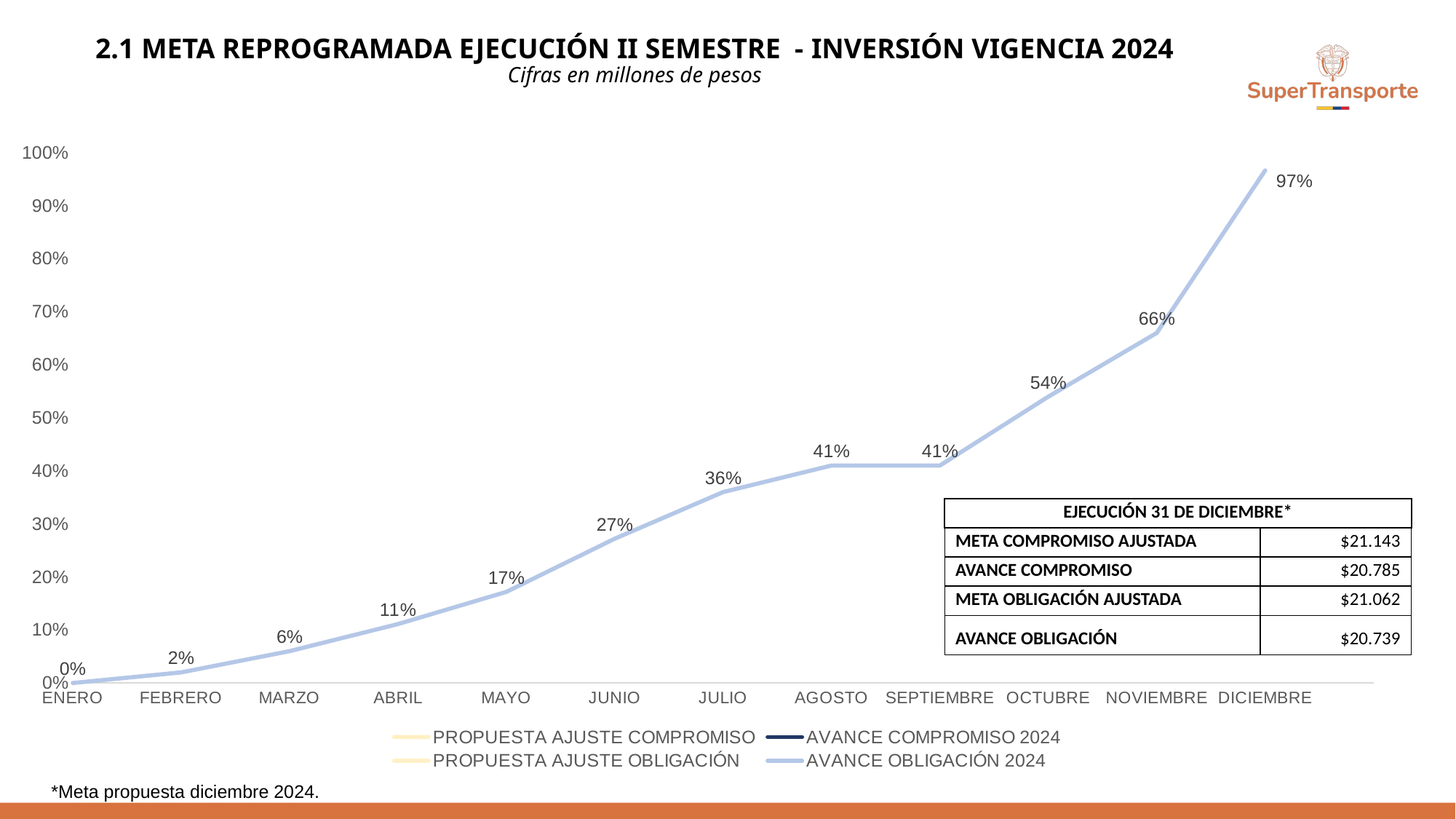
Which month has the highest value on the plotted line? DICIEMBRE Do the values rise or fall from ENERO to DICIEMBRE? Rise What is the difference between the values for DICIEMBRE and NOVIEMBRE? 31% Which month has the lowest value on the plotted line? ENERO What is the difference between the values for OCTUBRE and SEPTIEMBRE? 13% What kind of chart is shown on the slide? Line chart How many months are shown on the x axis? 12 Which is larger, the value for JUNIO or the value for ABRIL? JUNIO What is the value for JULIO on the plotted line? 36% What is the value for MAYO on the plotted line? 17% How many series does the legend list? 4 What is the value for DICIEMBRE on the plotted line? 97%